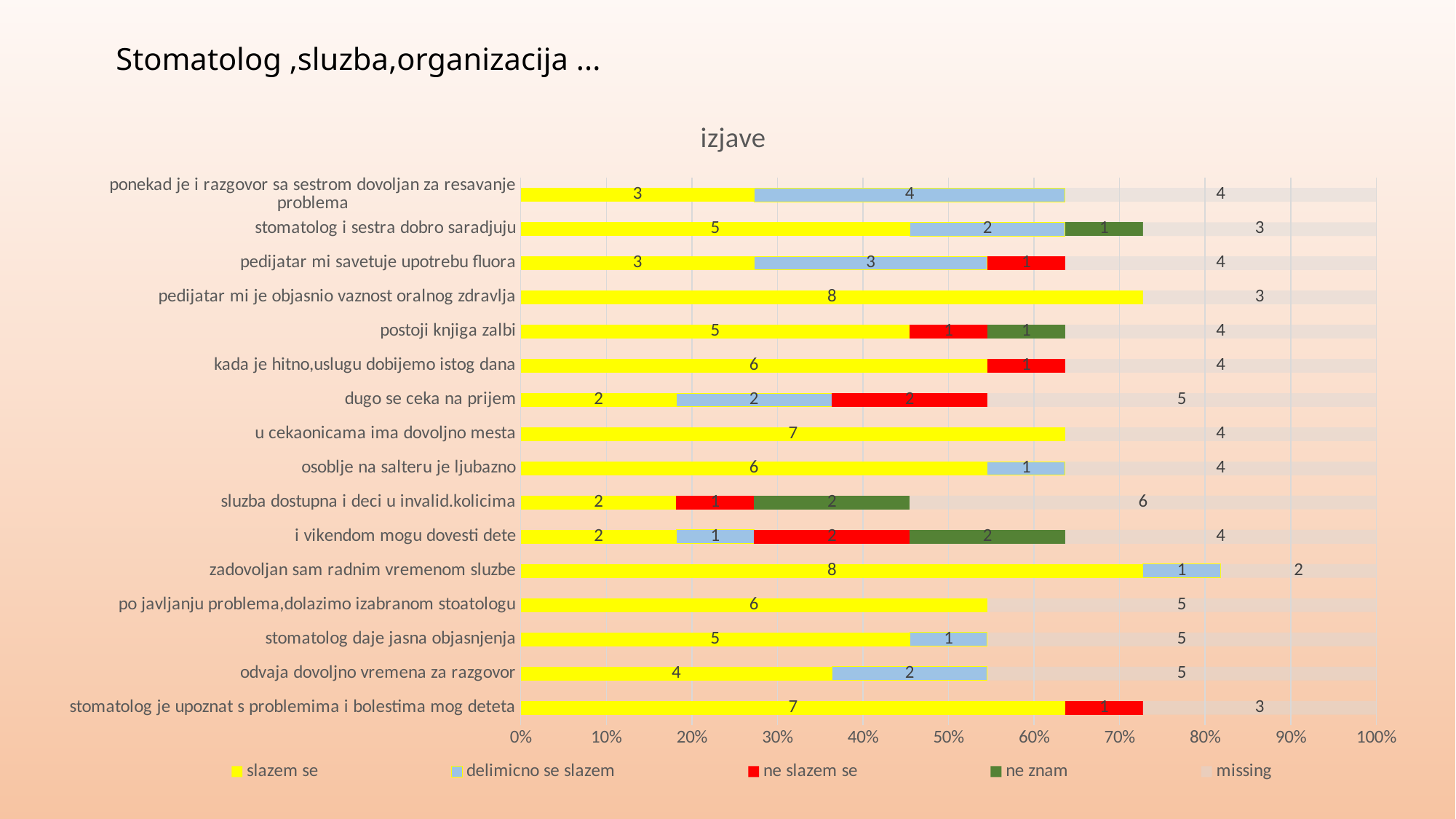
What type of chart is shown on the slide? stacked bar chart What is the 'missing' value for 'sluzba dostupna i deci u invalid.kolicima'? 6 What is the 'slazem se' value for 'u cekaonicama ima dovoljno mesta'? 7 How many statements (categories) are plotted in the chart? 16 Which has a larger 'slazem se' value: 'kada je hitno,uslugu dobijemo istog dana' or 'dugo se ceka na prijem'? kada je hitno,uslugu dobijemo istog dana Which statement has the highest 'missing' value? sluzba dostupna i deci u invalid.kolicima Which statement has the lowest 'missing' value? zadovoljan sam radnim vremenom sluzbe What is the 'ne slazem se' value for 'dugo se ceka na prijem'? 2 How many series does the legend list? 5 What is the 'delimicno se slazem' value for 'ponekad je i razgovor sa sestrom dovoljan za resavanje problema'? 4 What is the total of all segments in the bar for 'i vikendom mogu dovesti dete'? 11 What is the difference between the 'slazem se' values for 'pedijatar mi je objasnio vaznost oralnog zdravlja' and 'odvaja dovoljno vremena za razgovor'? 4